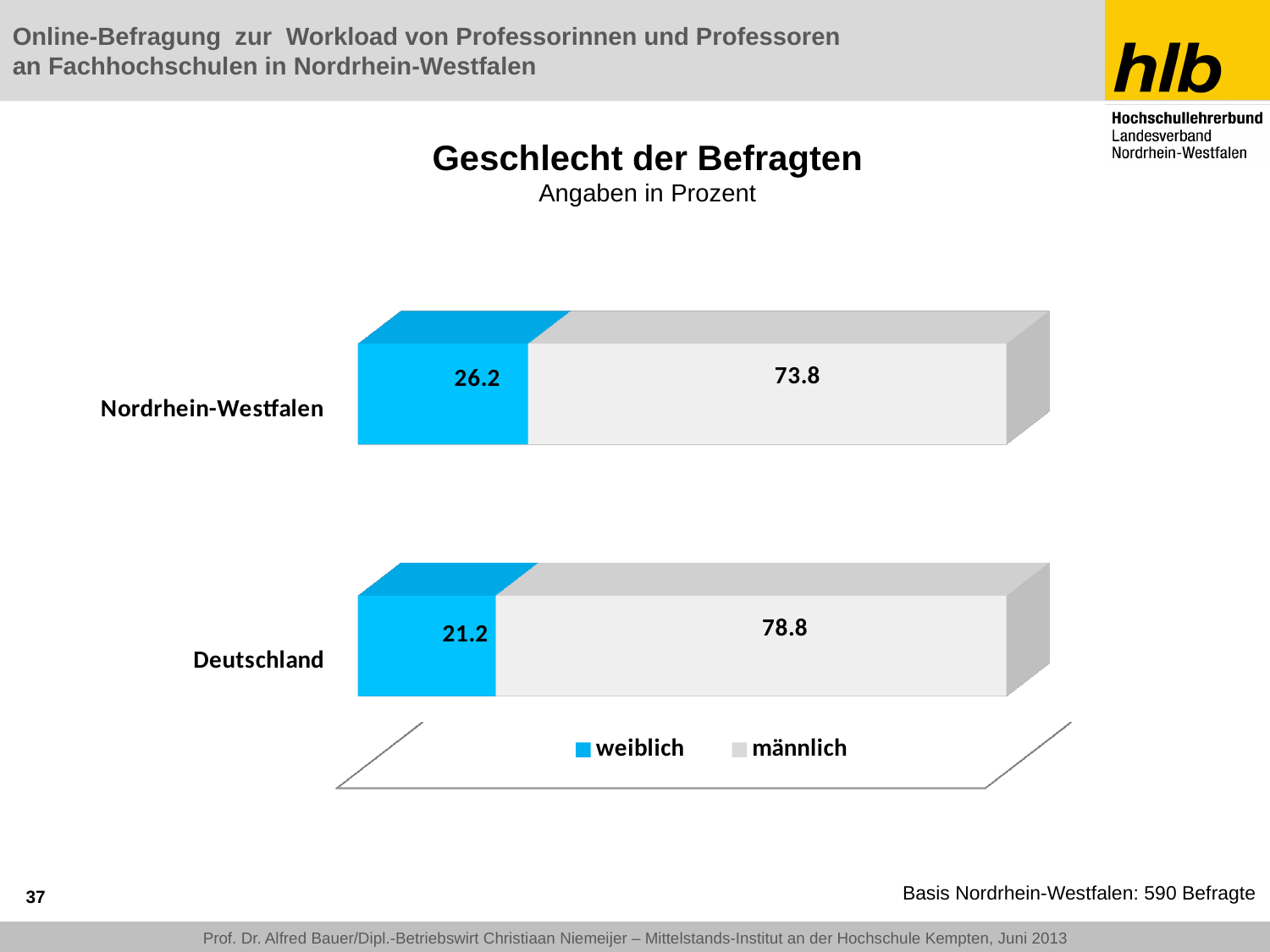
What kind of chart is shown on the slide? Stacked bar chart How many categories are shown in the chart? 2 Which category has the higher weiblich value, Nordrhein-Westfalen or Deutschland? Nordrhein-Westfalen How many series does the legend list? 2 What is the title of the chart? Geschlecht der Befragten What is the value for weiblich in Nordrhein-Westfalen? 26.2 What is the value for männlich in Deutschland? 78.8 What is the difference between the männlich and weiblich values for Deutschland? 57.6 What is the value for weiblich in Deutschland? 21.2 What is the total of the stacked bar for Nordrhein-Westfalen? 100.0 What is the value for männlich in Nordrhein-Westfalen? 73.8 What is the difference between the weiblich values for Nordrhein-Westfalen and Deutschland? 5.0